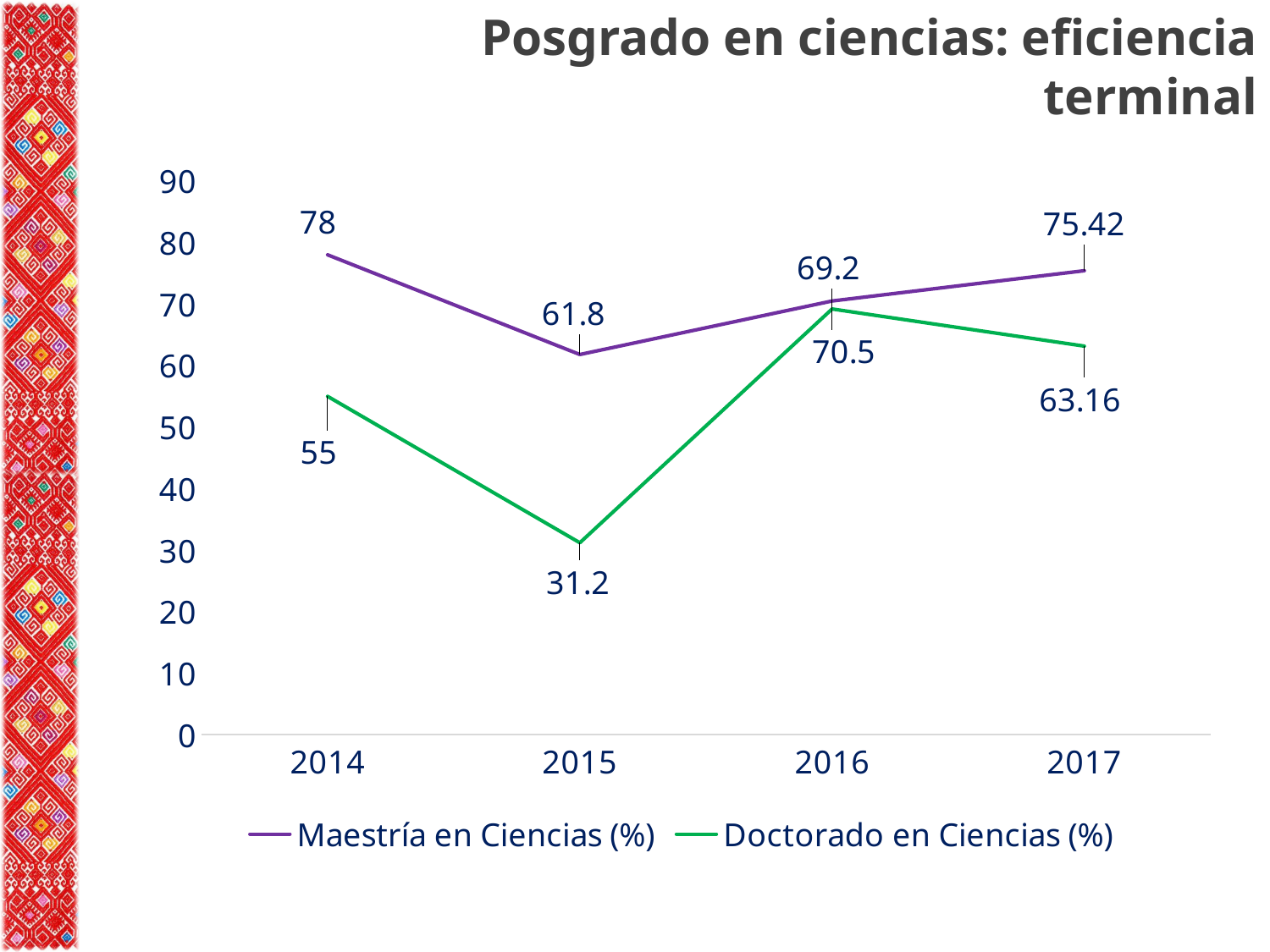
What is the title of the chart? Posgrado en ciencias: eficiencia terminal How many years are shown on the x axis? 4 What is the difference between Maestría en Ciencias (%) and Doctorado en Ciencias (%) in 2015? 30.6 In which year is Maestría en Ciencias (%) highest? 2014 What kind of chart is shown? Line chart Which is larger in 2014, Maestría en Ciencias (%) or Doctorado en Ciencias (%)? Maestría en Ciencias (%) In which year is Doctorado en Ciencias (%) lowest? 2015 What is the value for Maestría en Ciencias (%) in 2014? 78 What is the value for Maestría en Ciencias (%) in 2017? 75.42 What is the value for Doctorado en Ciencias (%) in 2015? 31.2 What is the value for Doctorado en Ciencias (%) in 2017? 63.16 How many series does the legend list? 2